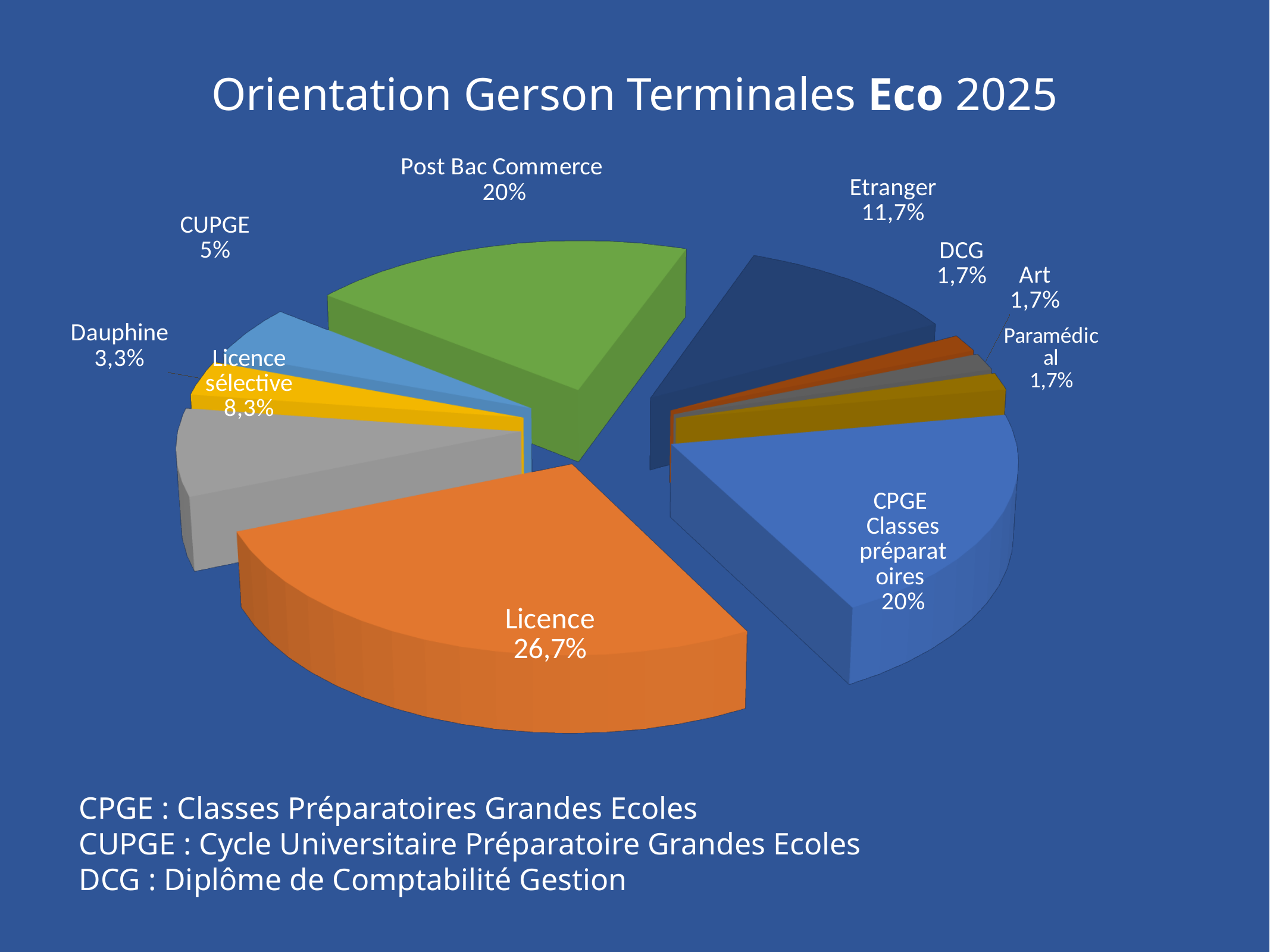
What is the title of the chart on the slide? Orientation Gerson Terminales Eco 2025 What share of the pie does Licence represent? 26,7% Which category has the largest slice of the pie? Licence How many slices does the pie chart have? 10 What is the value shown for Etranger? 11,7% What is the value shown for CUPGE? 5% What is the value shown for Licence sélective? 8,3% What is the value shown for Dauphine? 3,3% What is the combined share of DCG, Art and Paramédical? 5% Which is larger, the share for Etranger or the share for Licence sélective? Etranger What kind of chart is shown on the slide? pie chart What is the difference between the Licence share and the Post Bac Commerce share? 6,7%